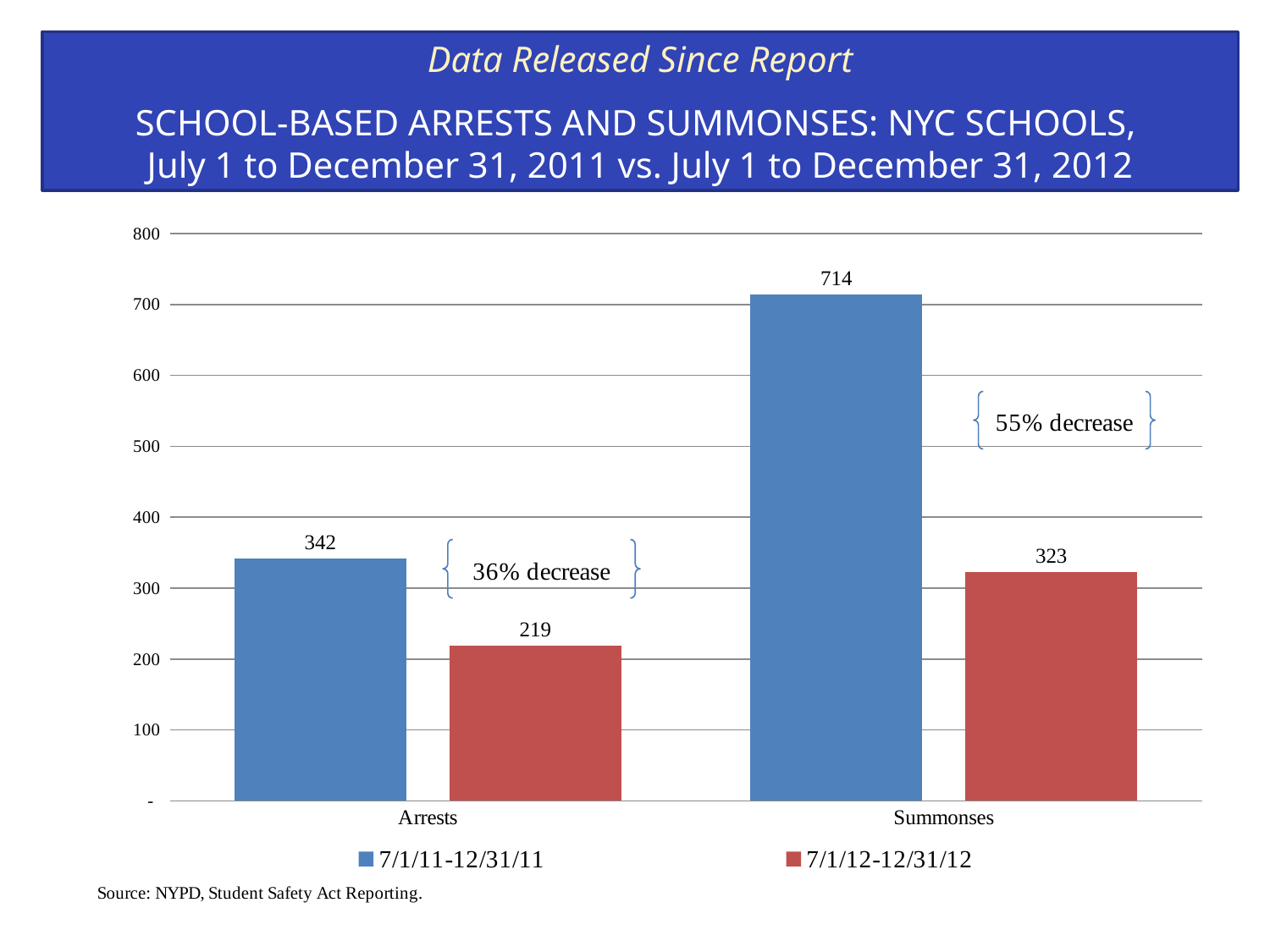
Is the value for Summonses in the 7/1/11-12/31/11 series greater or less than 700? greater Which bar has the lowest value on the chart? Arrests, 7/1/12-12/31/12 What is the value for Arrests in the 7/1/11-12/31/11 series? 342 Which is larger: Arrests for 7/1/11-12/31/11 or Summonses for 7/1/12-12/31/12? Arrests for 7/1/11-12/31/11 How many categories are shown on the x axis? 2 What is the difference between the Summonses values for 7/1/11-12/31/11 and 7/1/12-12/31/12? 391 What is the value for Arrests in the 7/1/12-12/31/12 series? 219 How many series does the legend list? 2 What is the difference between the Arrests values for 7/1/11-12/31/11 and 7/1/12-12/31/12? 123 What is the value for Summonses in the 7/1/12-12/31/12 series? 323 Which category has the highest value in the 7/1/11-12/31/11 series? Summonses What kind of chart is shown on the slide? Bar chart